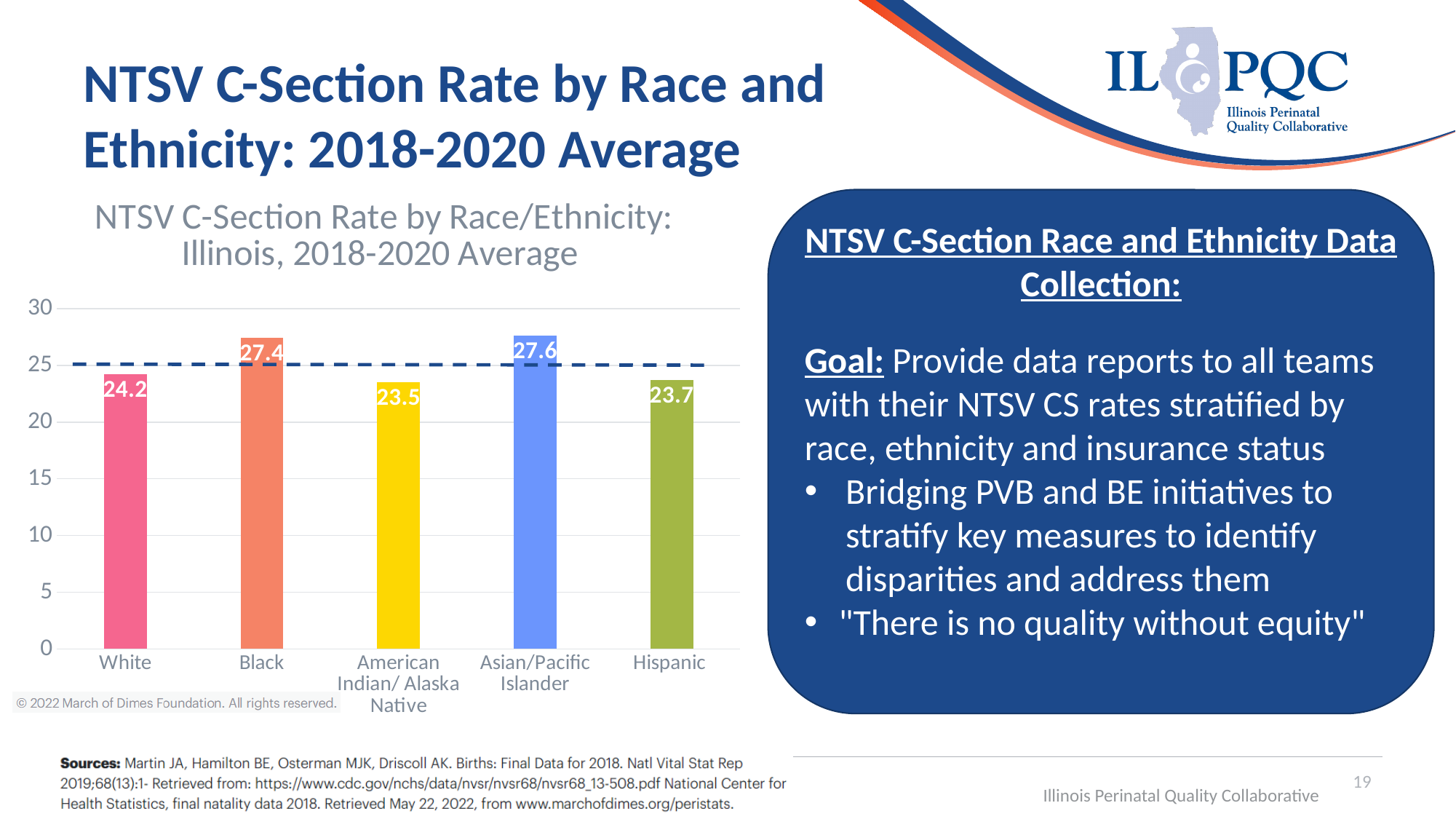
Which has a higher NTSV C-section rate, White or Hispanic? White How many race/ethnicity categories are shown in the chart? 5 What is the NTSV C-section rate for Black in the chart? 27.4 What is the NTSV C-section rate for American Indian/ Alaska Native? 23.5 What is the difference between the NTSV C-section rates for Black and White? 3.2 Is the value for Asian/Pacific Islander greater or less than 25? greater What kind of chart is shown on the slide? Bar chart What is the NTSV C-section rate for White in the chart? 24.2 Which race/ethnicity category has the highest NTSV C-section rate? Asian/Pacific Islander What is the NTSV C-section rate for Hispanic? 23.7 Which race/ethnicity category has the lowest NTSV C-section rate? American Indian/ Alaska Native What is the title of the chart? NTSV C-Section Rate by Race/Ethnicity: Illinois, 2018-2020 Average